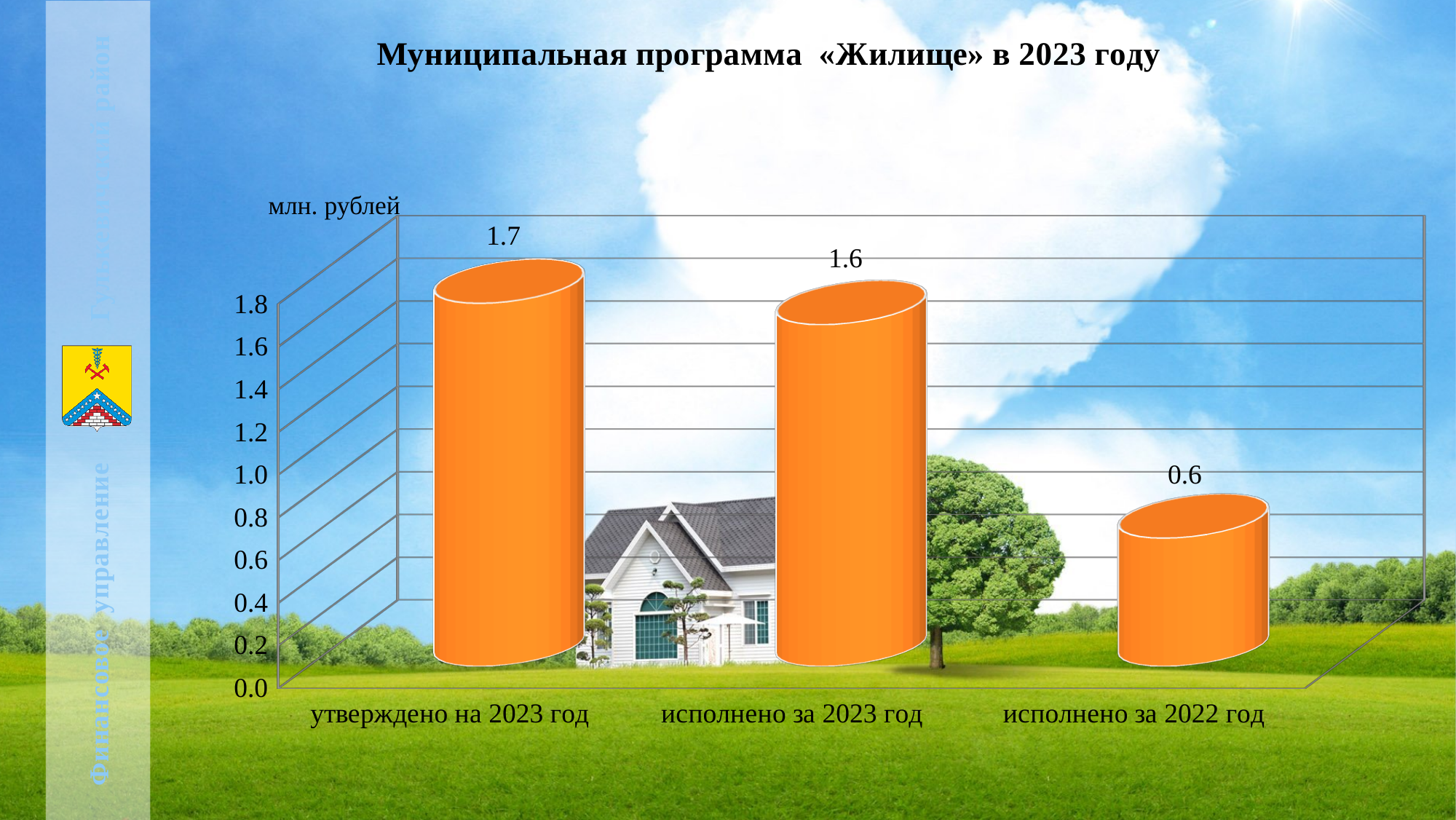
What is the value for «утверждено на 2023 год»? 1.7 Which category has the lowest value? исполнено за 2022 год What is the value for «исполнено за 2022 год»? 0.6 How many categories are shown on the chart? 3 Which is larger: the value for «исполнено за 2023 год» or «исполнено за 2022 год»? исполнено за 2023 год What kind of chart is shown on the slide? bar chart What unit is indicated on the chart's axis label? млн. рублей What is the difference between the values for «утверждено на 2023 год» and «исполнено за 2023 год»? 0.1 What is the difference between the values for «исполнено за 2023 год» and «исполнено за 2022 год»? 1.0 Which category has the highest value? утверждено на 2023 год What is the value for «исполнено за 2023 год»? 1.6 Is the value for «исполнено за 2022 год» greater or less than 1.0? less